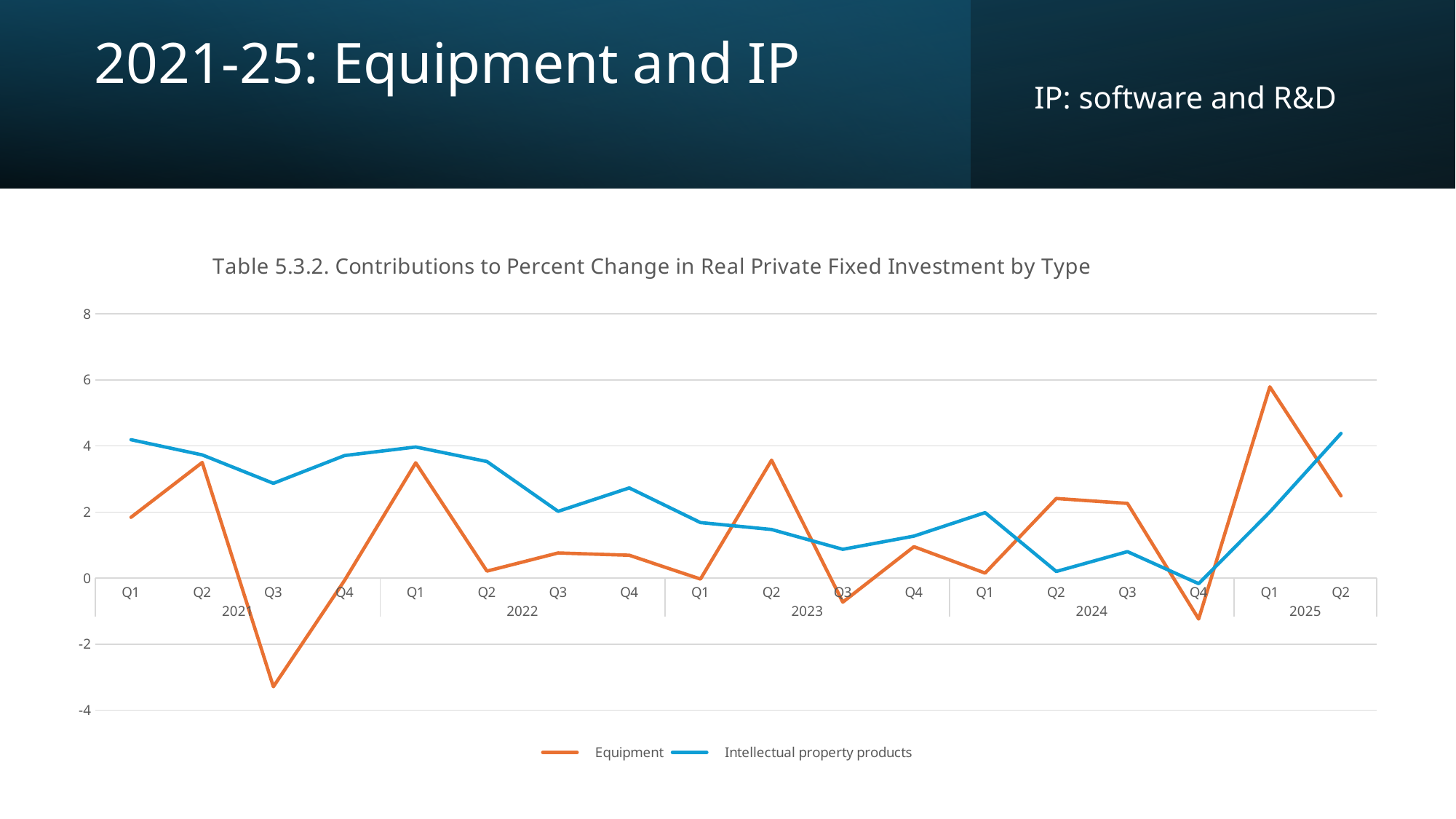
In which quarter does the Intellectual property products series reach its lowest value? Q4 2024 How many series does the legend list? 2 In Q1 2021, which series has the larger value, Equipment or Intellectual property products? Intellectual property products Which colour is used for the Equipment line? Orange In which quarter does the Equipment series reach its highest value? Q1 2025 Is the Equipment value for Q3 2021 greater or less than -2? less In Q2 2023, which series has the larger value, Equipment or Intellectual property products? Equipment How many quarterly data points are plotted along the x axis? 18 Is the Intellectual property products value for Q3 2022 greater or less than 4? less What kind of chart is shown on the slide? Line chart Is the Equipment value for Q1 2025 greater or less than 4? greater In which quarter does the Equipment series reach its lowest value? Q3 2021